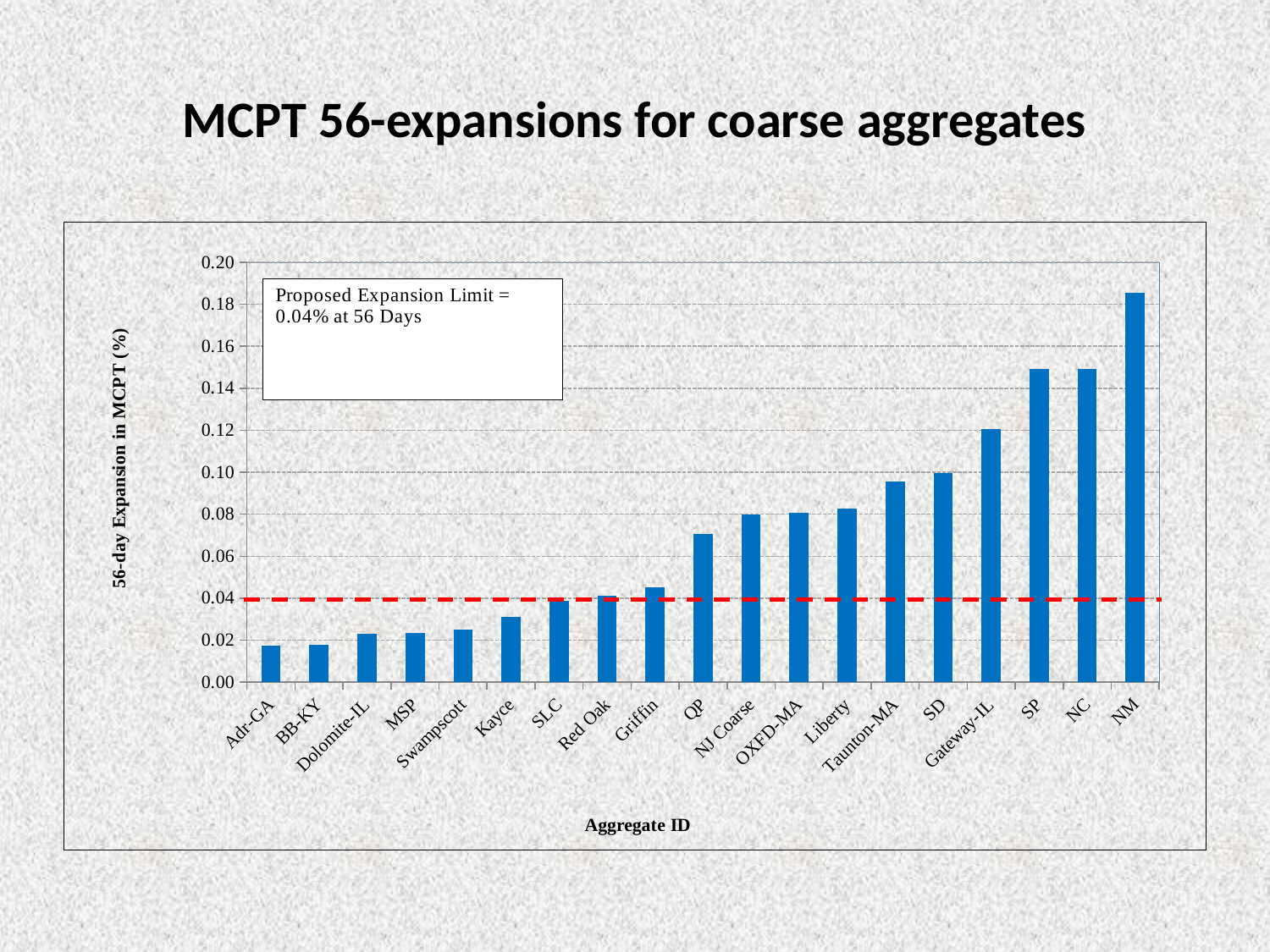
Is the value for NM greater or less than 0.18? greater Which aggregate has the highest 56-day expansion in MCPT? NM Do the bar values generally rise or fall from left to right along the x axis? Rise What kind of chart is shown on the slide? Bar chart Is the value for Taunton-MA greater or less than 0.08? greater Is the value for QP greater or less than 0.06? greater What proposed expansion limit is stated in the text box on the chart? 0.04% at 56 Days What is the title of the x axis? Aggregate ID Which has a larger 56-day expansion, Liberty or Kayce? Liberty How many aggregate IDs are plotted along the x axis? 19